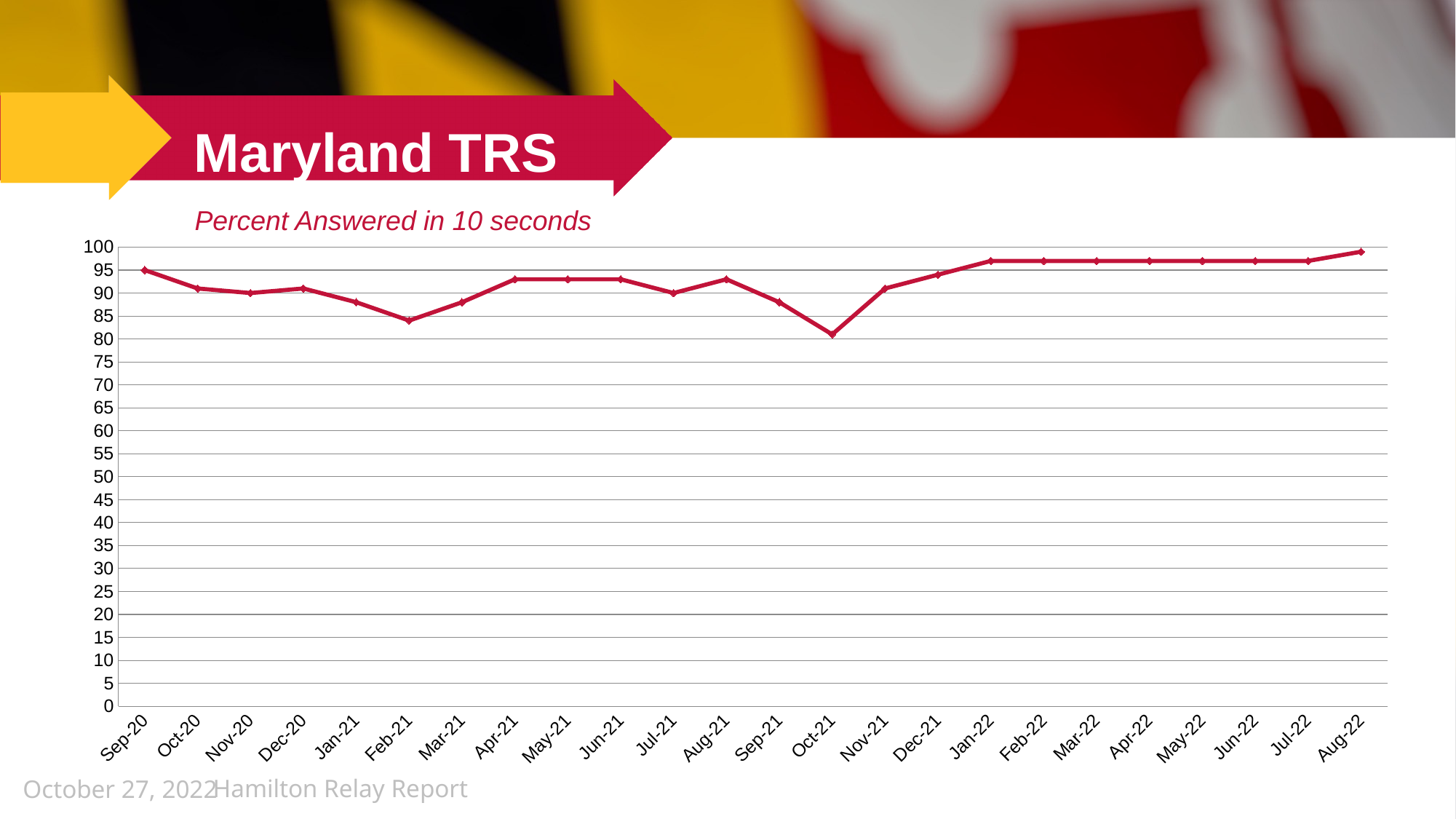
Is the value for Apr-21 greater or less than 90? greater From Oct-21 to Aug-22, does the percent answered in 10 seconds rise or fall? rise Which is larger, the value for Feb-21 or the value for Oct-21? Feb-21 What kind of chart is shown on the slide? line chart Which month has the lowest percent answered in 10 seconds? Oct-21 Which is larger, the value for Jan-21 or the value for Apr-21? Apr-21 What is the title of the chart? Percent Answered in 10 seconds How many months are plotted along the x axis? 24 Is the value for Jan-22 greater or less than 95? greater Is the value for Oct-21 greater or less than 85? less Which month has the highest percent answered in 10 seconds? Aug-22